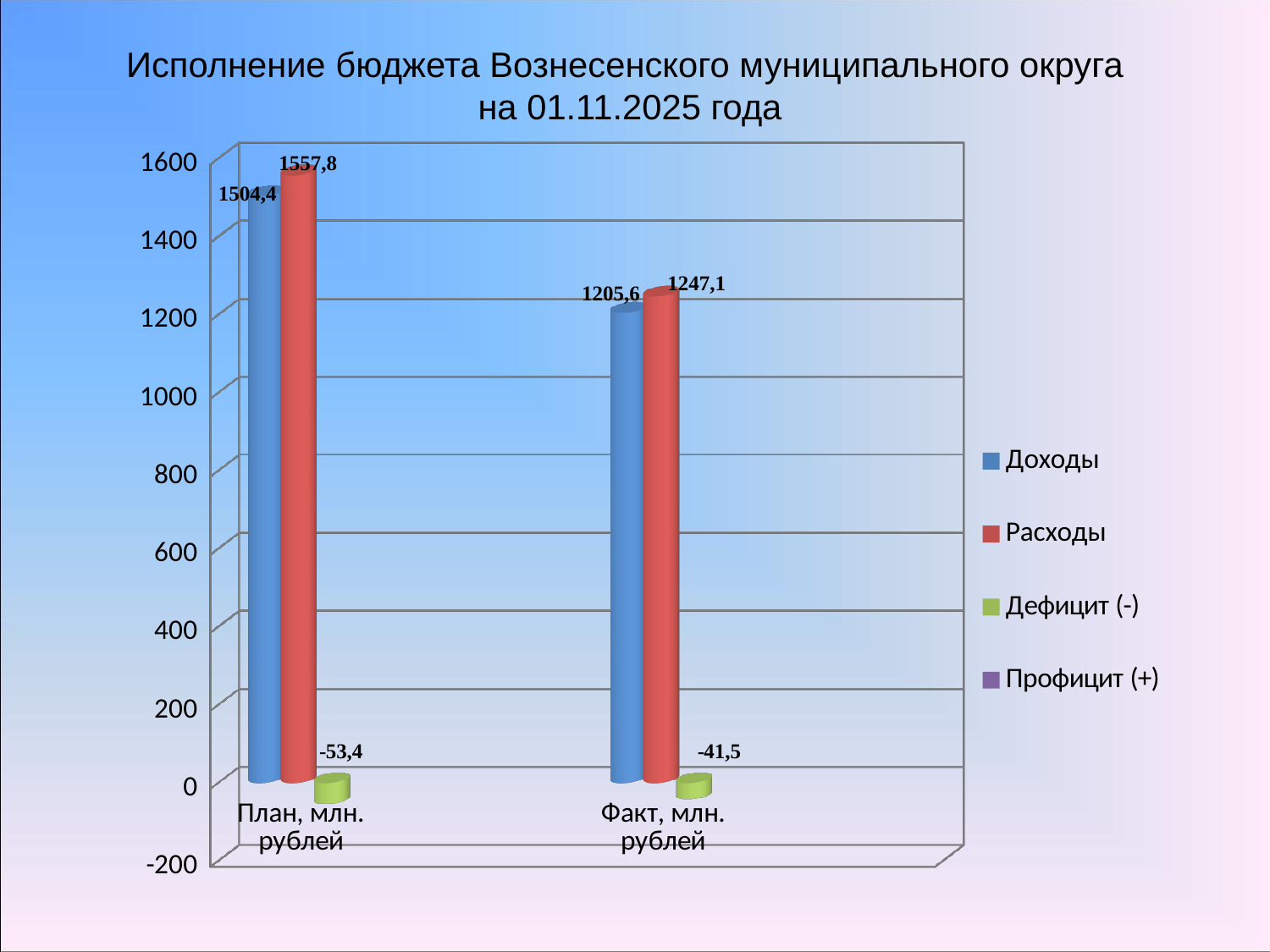
What kind of chart is shown on the slide? Bar chart What is the difference between Расходы and Доходы for План, млн. рублей? 53,4 How many categories are shown on the x axis? 2 How many series does the legend list? 4 What is the value of Расходы for Факт, млн. рублей? 1247,1 What is the value of Доходы for План, млн. рублей? 1504,4 What is the value of Дефицит (-) for Факт, млн. рублей? -41,5 What is the value of Дефицит (-) for План, млн. рублей? -53,4 For Факт, млн. рублей, which is larger: Доходы or Расходы? Расходы Which category has the higher value for Расходы, План or Факт? План, млн. рублей Is the value of Доходы for Факт, млн. рублей greater or less than 1400? less What is the difference between Доходы for План and Доходы for Факт? 298,8